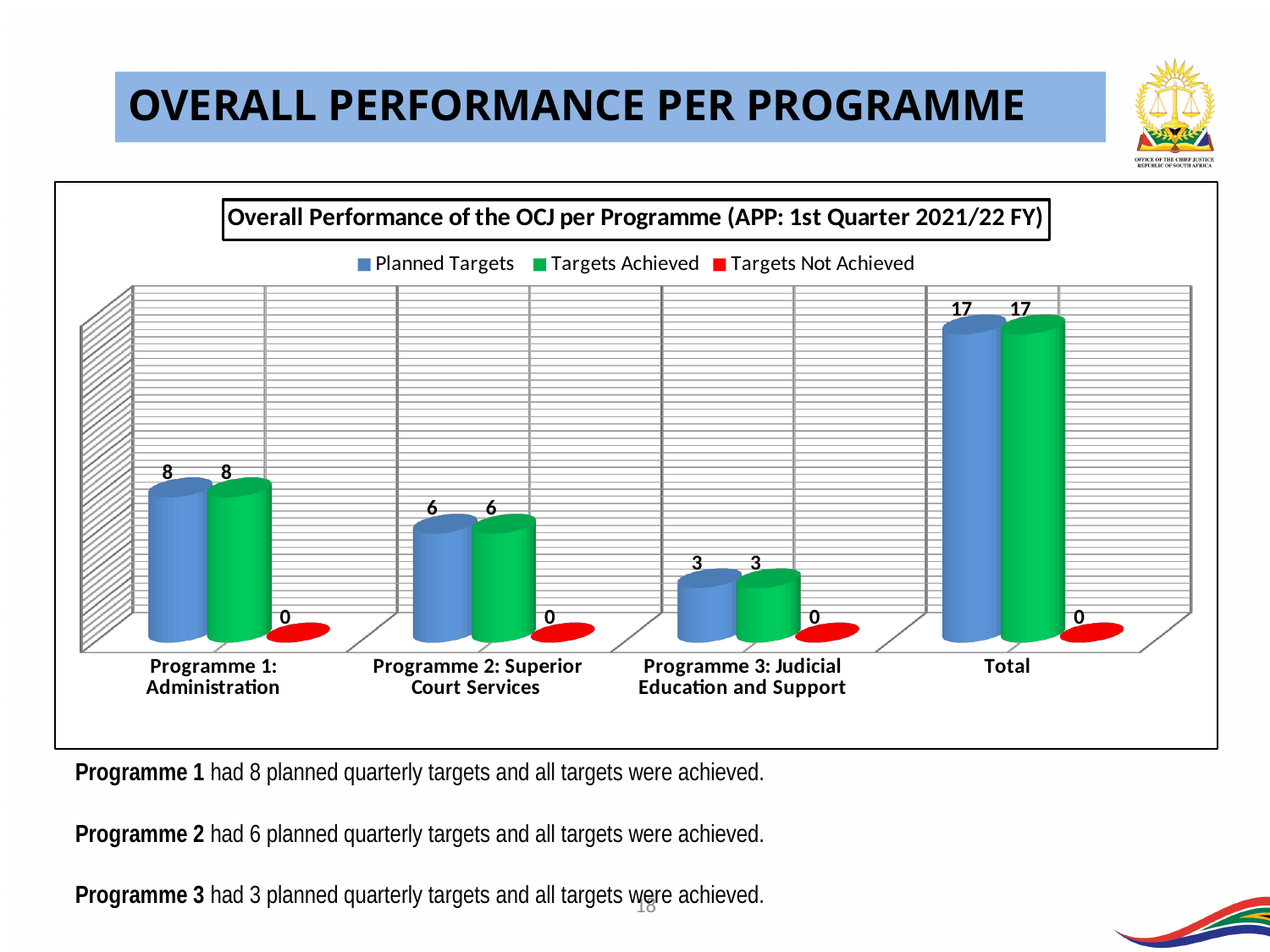
How many series does the legend list? 3 Which category has the highest Planned Targets value? Total Among the three programmes, which has the lowest Targets Achieved value? Programme 3: Judicial Education and Support What is the value of Targets Not Achieved for Programme 3: Judicial Education and Support? 0 What is the value of Planned Targets for Programme 1: Administration? 8 What kind of chart is shown on the slide? Bar chart How many categories are shown on the x axis? 4 What is the title of the chart? Overall Performance of the OCJ per Programme (APP: 1st Quarter 2021/22 FY) Which is larger: Targets Achieved for Programme 2: Superior Court Services or for Programme 3: Judicial Education and Support? Programme 2: Superior Court Services What is the difference between Planned Targets for Programme 1: Administration and Programme 2: Superior Court Services? 2 What is the value of Planned Targets for Total? 17 What is the value of Targets Achieved for Programme 2: Superior Court Services? 6